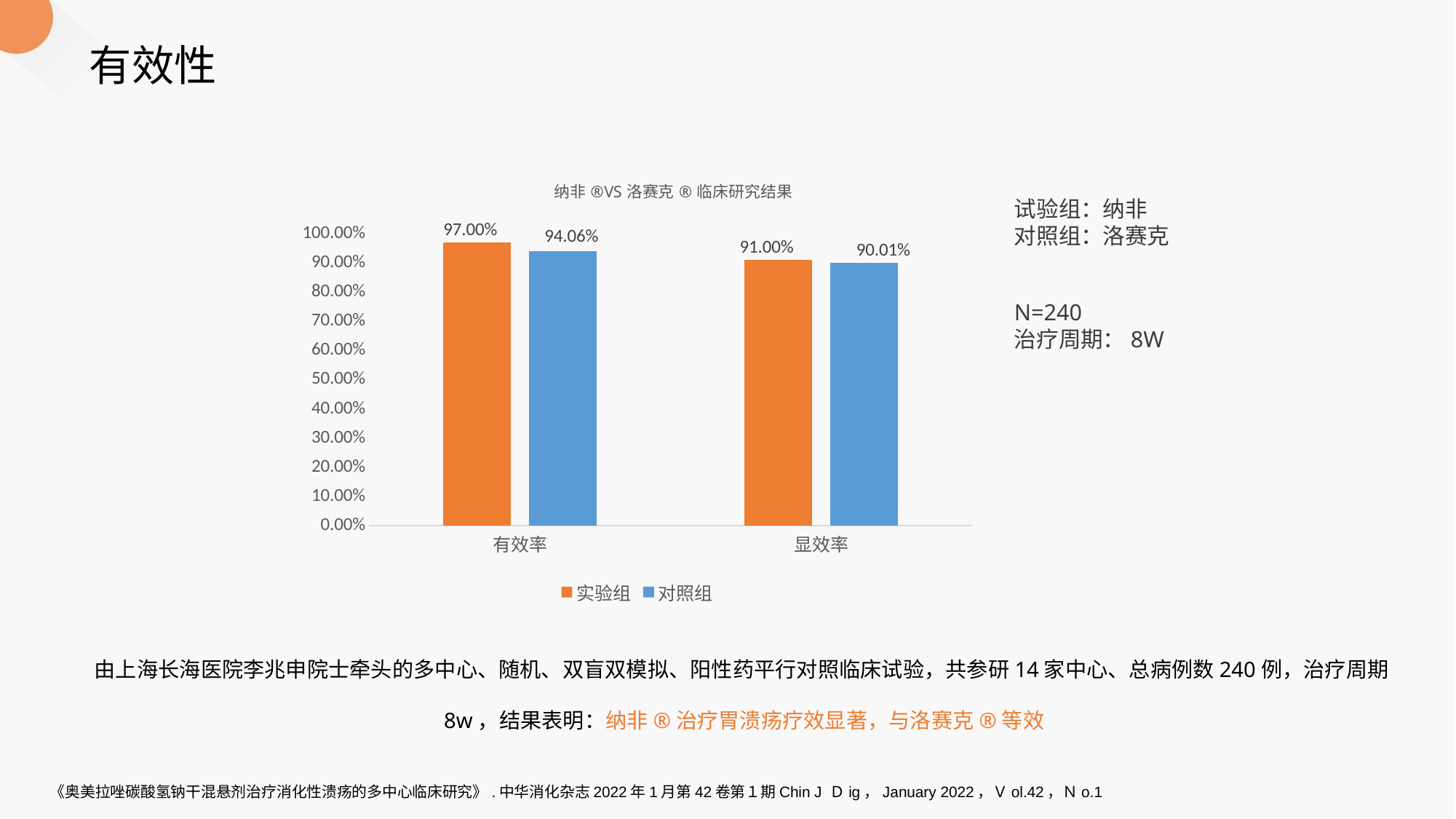
What is the difference between 实验组 and 对照组 in the 显效率 category? 0.99% What is the value for 实验组 in the 显效率 category? 91.00% What type of chart is shown on the slide? Bar chart How many series does the legend list? 2 How many categories are shown on the x axis? 2 Which category has the highest value for 实验组? 有效率 What is the value for 对照组 in the 显效率 category? 90.01% Which series has the higher value in the 有效率 category? 实验组 Which category has the lowest value for 对照组? 显效率 What is the value for 对照组 in the 有效率 category? 94.06% What is the value for 实验组 in the 有效率 category? 97.00% What is the difference between 实验组 and 对照组 in the 有效率 category? 2.94%